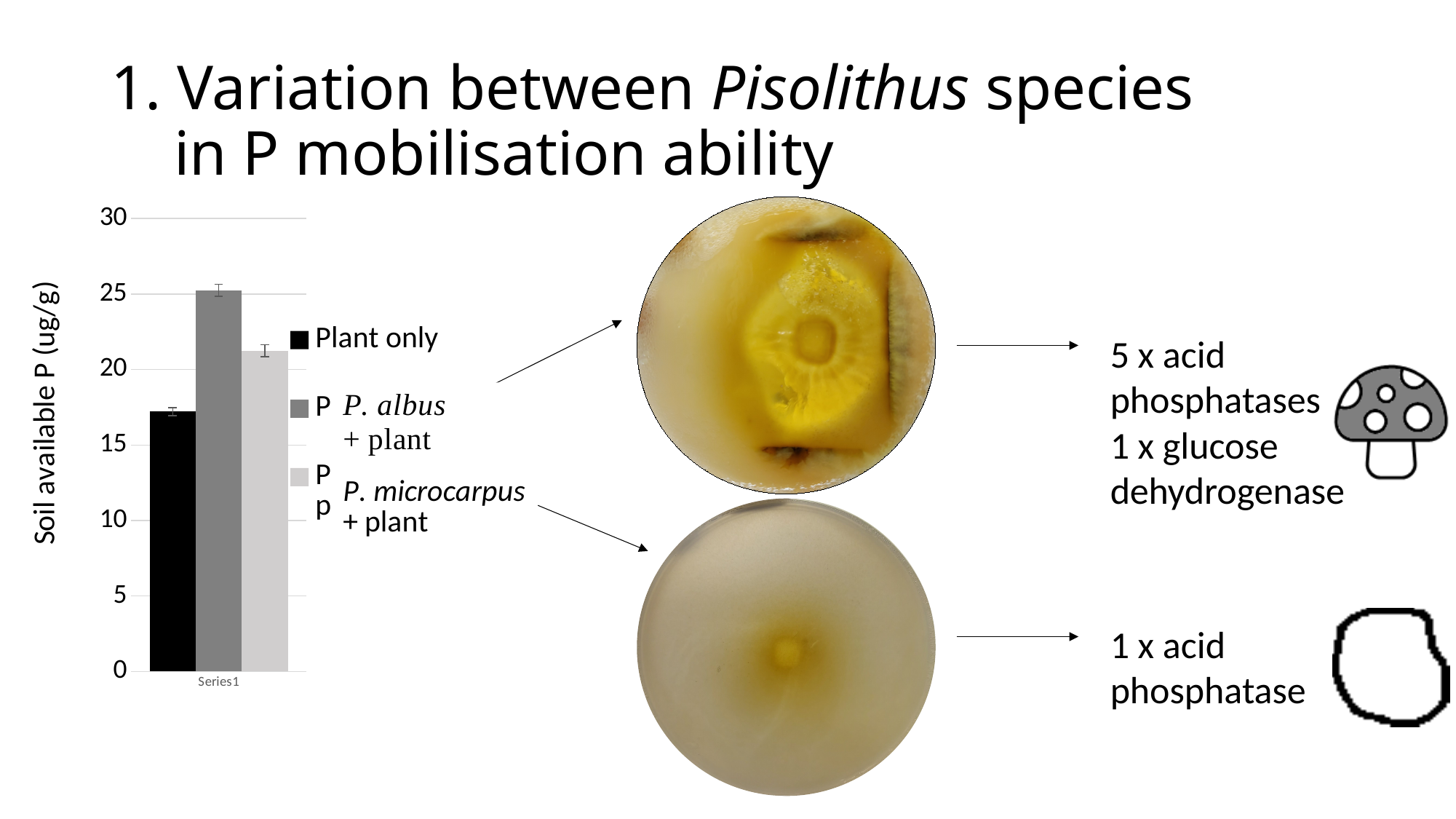
How many bars are plotted in the chart? 3 Is the soil available P value for Plant only greater or less than 20? less Is the soil available P value for P. microcarpus + plant greater or less than 20? greater What is the label of the vertical axis of the chart? Soil available P (ug/g) What kind of chart is shown on the slide? bar chart Which has a higher soil available P value: P. albus + plant or P. microcarpus + plant? P. albus + plant How many series does the chart's legend list? 3 Which treatment has the highest soil available P? P. albus + plant Which has a lower soil available P value: Plant only or P. microcarpus + plant? Plant only Is the soil available P value for P. albus + plant greater or less than 30? less Which treatment has the lowest soil available P? Plant only